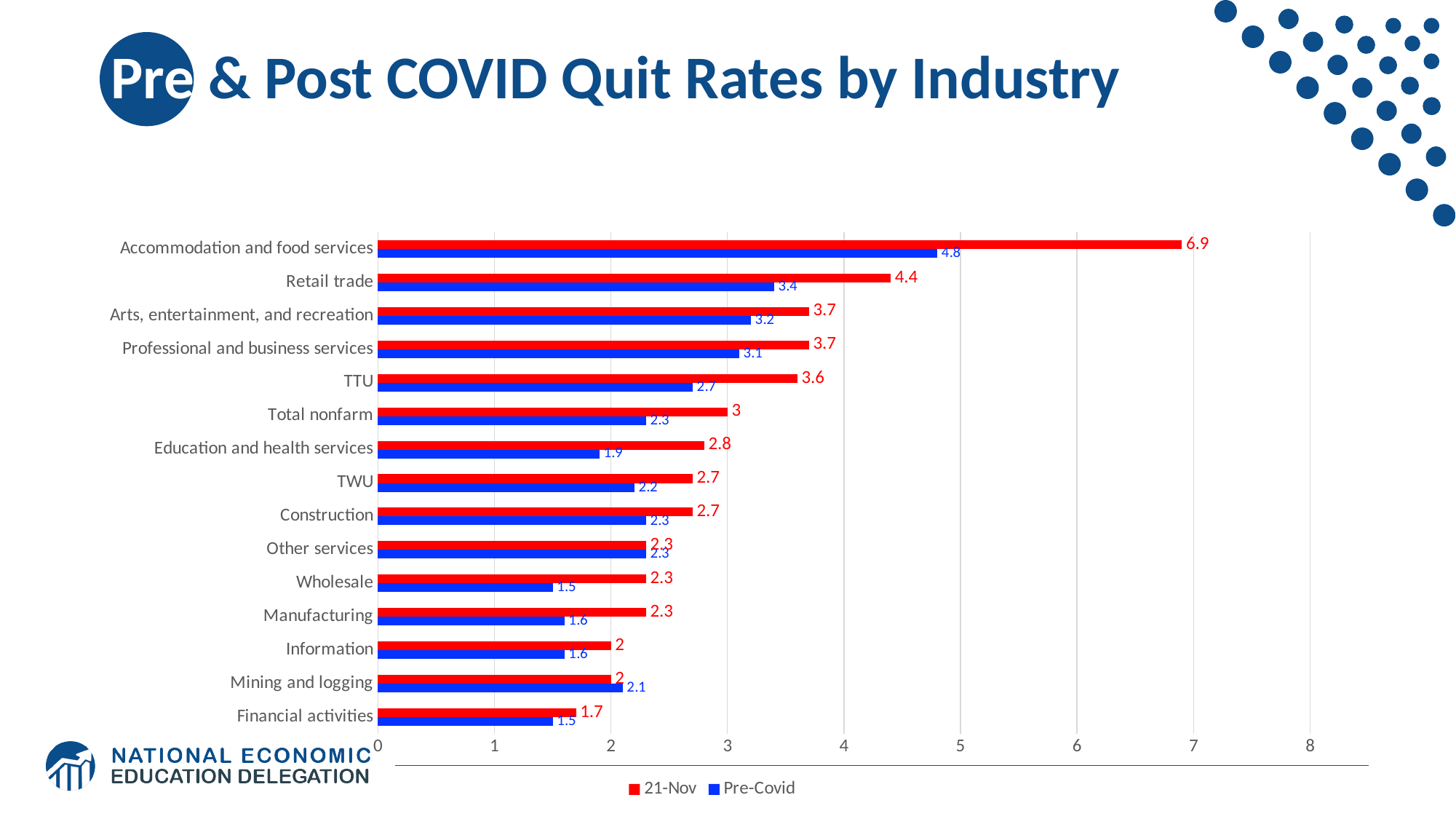
Which industry has the highest 21-Nov quit rate? Accommodation and food services What is the difference between the 21-Nov and Pre-Covid quit rates for Retail trade? 1 Which industry has the lowest 21-Nov quit rate? Financial activities What is the difference between the 21-Nov and Pre-Covid quit rates for Accommodation and food services? 2.1 What is the 21-Nov quit rate for Accommodation and food services? 6.9 What is the Pre-Covid quit rate for Retail trade? 3.4 What is the Pre-Covid quit rate for Education and health services? 1.9 For Mining and logging, which is larger: the 21-Nov quit rate or the Pre-Covid quit rate? Pre-Covid How many series does the legend list? 2 What kind of chart is shown on the slide? Bar chart Which colour represents the Pre-Covid series? Blue How many industries are shown on the chart? 15